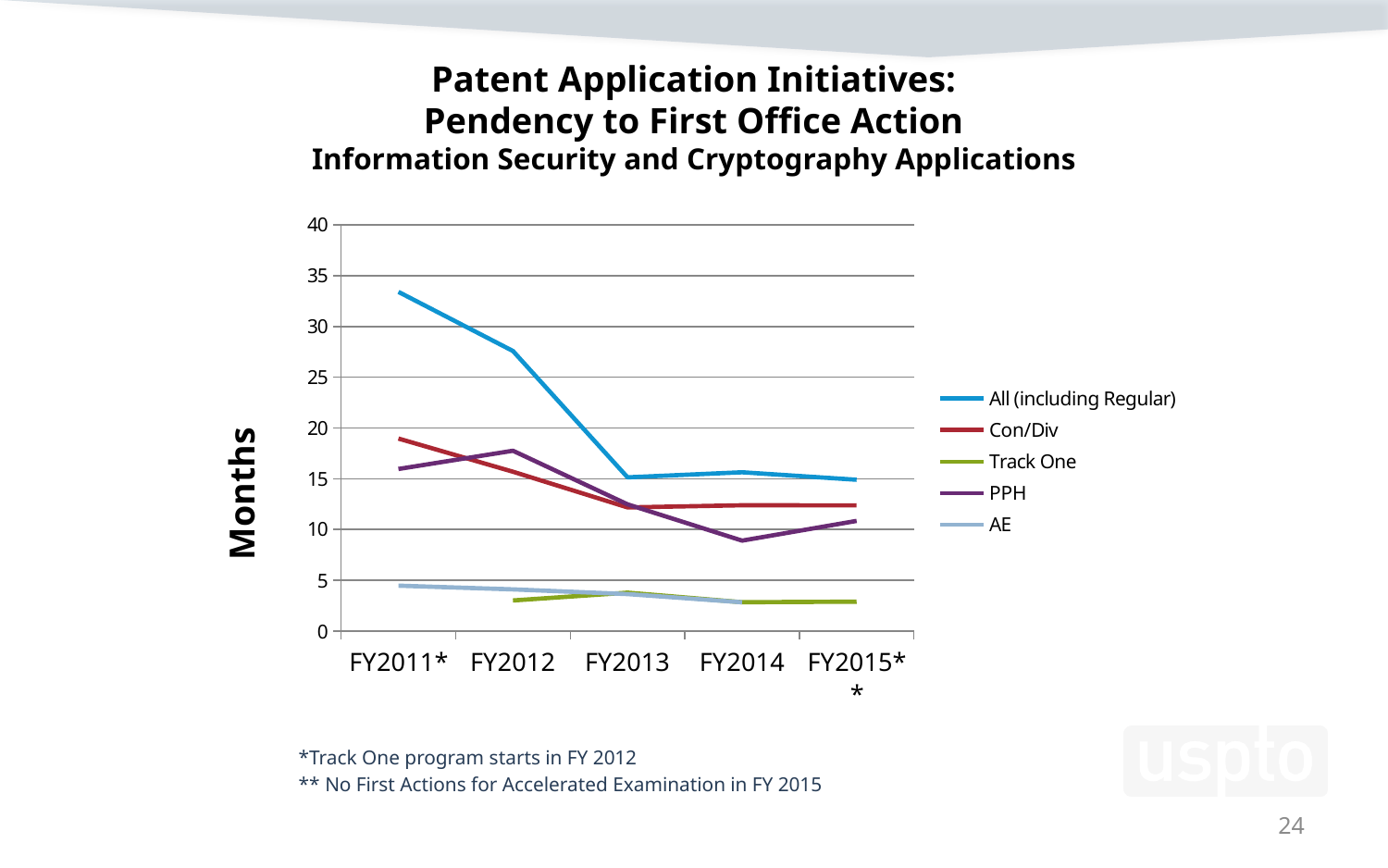
Is the value for All (including Regular) in FY2013 greater or less than 20? less What kind of chart is shown on the slide? line chart Is the value for All (including Regular) in FY2011* greater or less than 30? greater Which series has the lowest value in FY2015**? Track One Does the All (including Regular) series rise or fall from FY2011* to FY2013? fall Which series has the highest value in FY2011*? All (including Regular) What is the label on the y axis? Months In FY2012, which is higher: Con/Div or PPH? PPH How many series does the legend list? 5 Is the value for PPH in FY2014 greater or less than 10? less How many fiscal years are shown on the x axis? 5